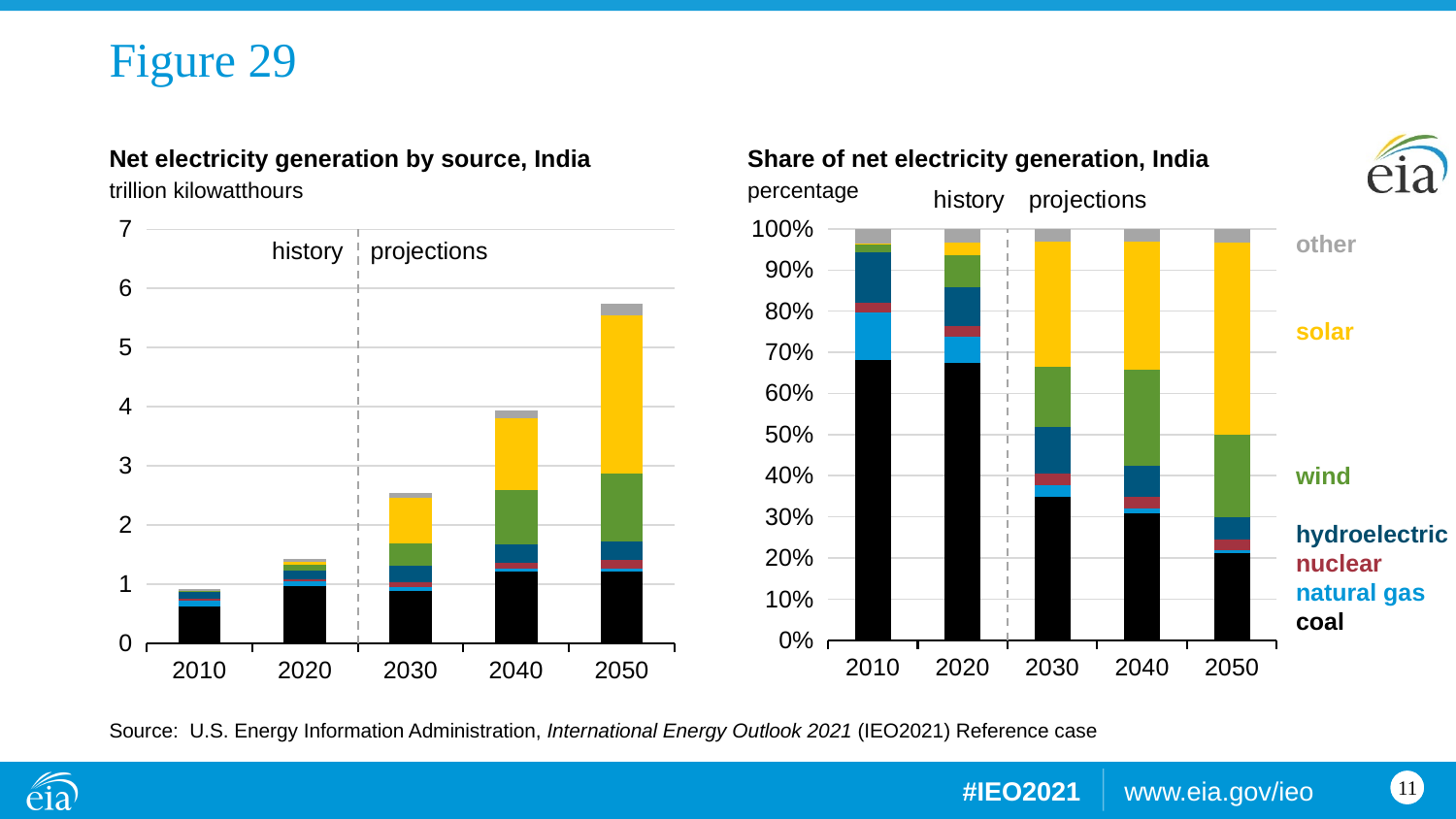
What unit is given under the title of the left chart, 'Net electricity generation by source, India'? trillion kilowatthours How many sources does the legend of the right chart, 'Share of net electricity generation, India', list? 7 In the left chart, 'Net electricity generation by source, India', which year has the tallest total bar? 2050 In the right chart, 'Share of net electricity generation, India', is the coal share in 2010 greater or less than 60%? greater In the right chart, 'Share of net electricity generation, India', does the coal share rise or fall from 2010 to 2050? fall In the left chart, 'Net electricity generation by source, India', is the total for 2030 greater or less than 2 trillion kilowatthours? greater What kind of chart is the left chart, 'Net electricity generation by source, India'? stacked bar chart In the left chart, 'Net electricity generation by source, India', how many years are shown on the x axis? 5 In the left chart, 'Net electricity generation by source, India', which year has the shortest total bar? 2010 In the right chart, 'Share of net electricity generation, India', is the coal share in 2050 greater or less than 30%? less In the left chart, 'Net electricity generation by source, India', does total generation rise or fall from 2010 to 2050? rise